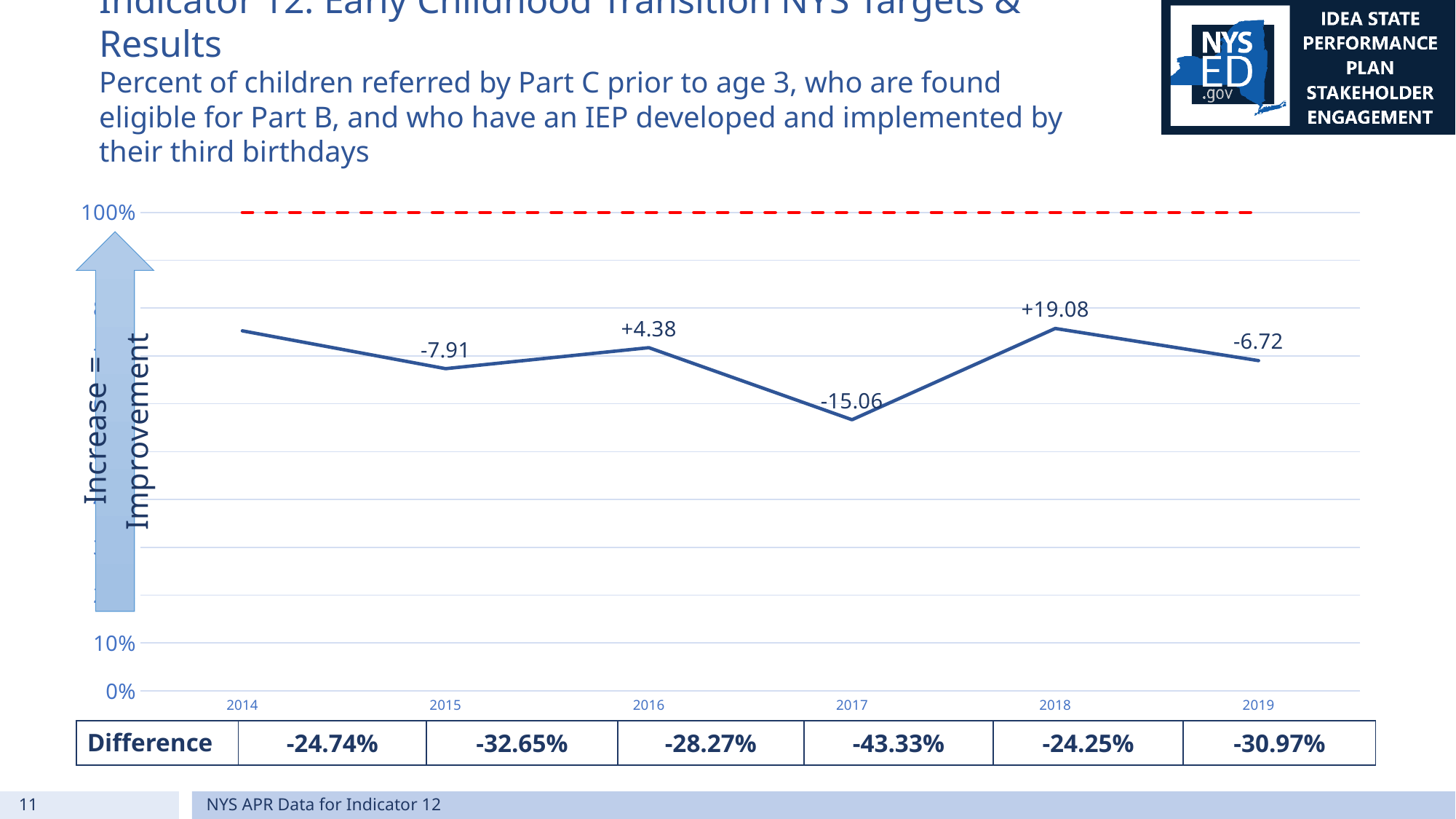
Which year has the largest negative difference in the Difference row? 2017 What kind of chart is shown on the slide? line chart At what level is the dashed red target line drawn on the chart? 100% What change label is shown on the data point for 2016? +4.38 According to the Difference row, what is the difference for 2015? -32.65% Which year has the lowest plotted value on the line? 2017 According to the Difference row, what is the difference for 2017? -43.33% How many years are plotted on the x axis of the chart? 6 What change label is shown on the data point for 2018? +19.08 Does the line rise or fall from 2016 to 2017? fall Is the plotted value for 2017 greater or less than 70%? less What change label is shown on the data point for 2017? -15.06